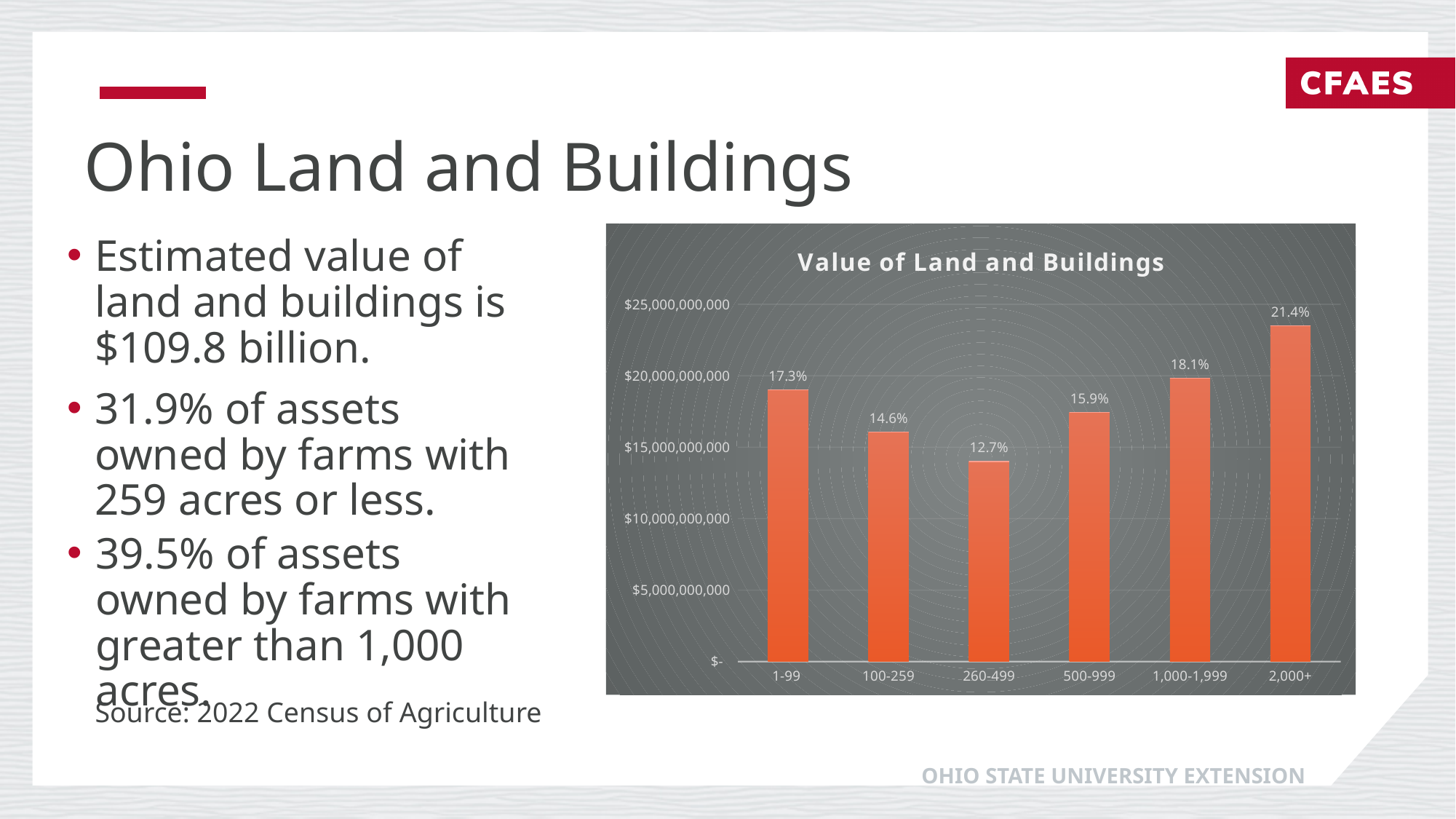
What data label is shown on the bar for the 2,000+ acre category? 21.4% Which bar is taller, 1,000-1,999 or 500-999? 1,000-1,999 What kind of chart is shown on the slide? Bar chart What is the difference in percentage points between the labels for the 2,000+ and 260-499 categories? 8.7 percentage points What data label is shown on the bar for the 1-99 acre category? 17.3% Is the value for the 2,000+ category greater or less than $20,000,000,000? greater What data label is shown on the bar for the 260-499 acre category? 12.7% Is the value for the 260-499 category greater or less than $15,000,000,000? less How many acreage categories are shown on the x axis? 6 What is the title of the chart? Value of Land and Buildings Which acreage category has the highest bar? 2,000+ Which acreage category has the lowest bar? 260-499